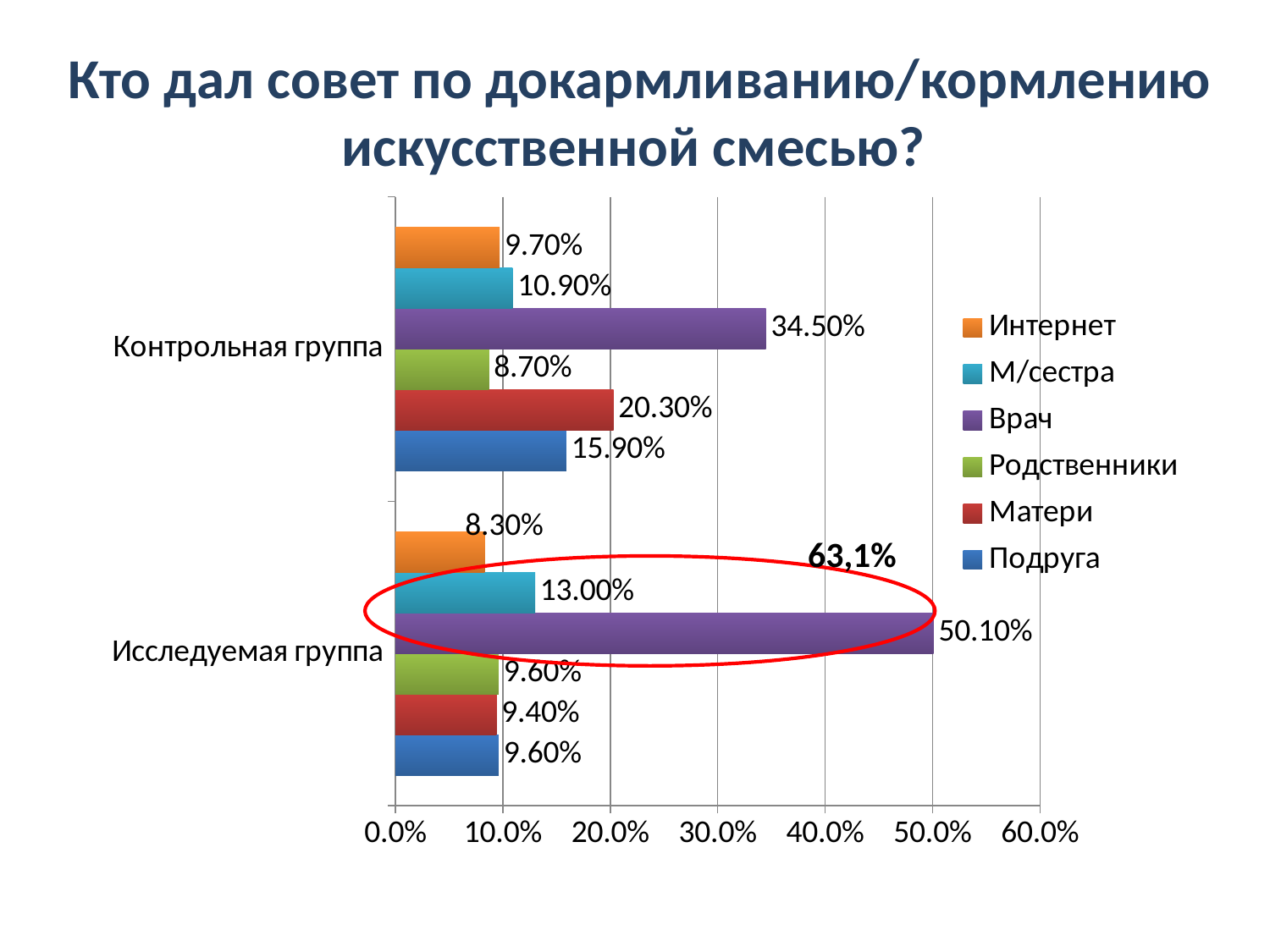
How many groups (categories) are shown on the vertical axis? 2 How many series does the legend list? 6 Which series has the lowest value in the Контрольная группа? Родственники Which is larger: Подруга in the Контрольная группа or Подруга in the Исследуемая группа? Контрольная группа What is the value for Матери in the Контрольная группа? 20.30% What is the value for Врач in the Исследуемая группа? 50.10% What is the difference between the Врач values for the Исследуемая группа and the Контрольная группа? 15.60% What is the value for М/сестра in the Исследуемая группа? 13.00% What is the value for Врач in the Контрольная группа? 34.50% What kind of chart is shown on the slide? bar chart Which series has the highest value in the Исследуемая группа? Врач Which series is shown in orange in the legend? Интернет